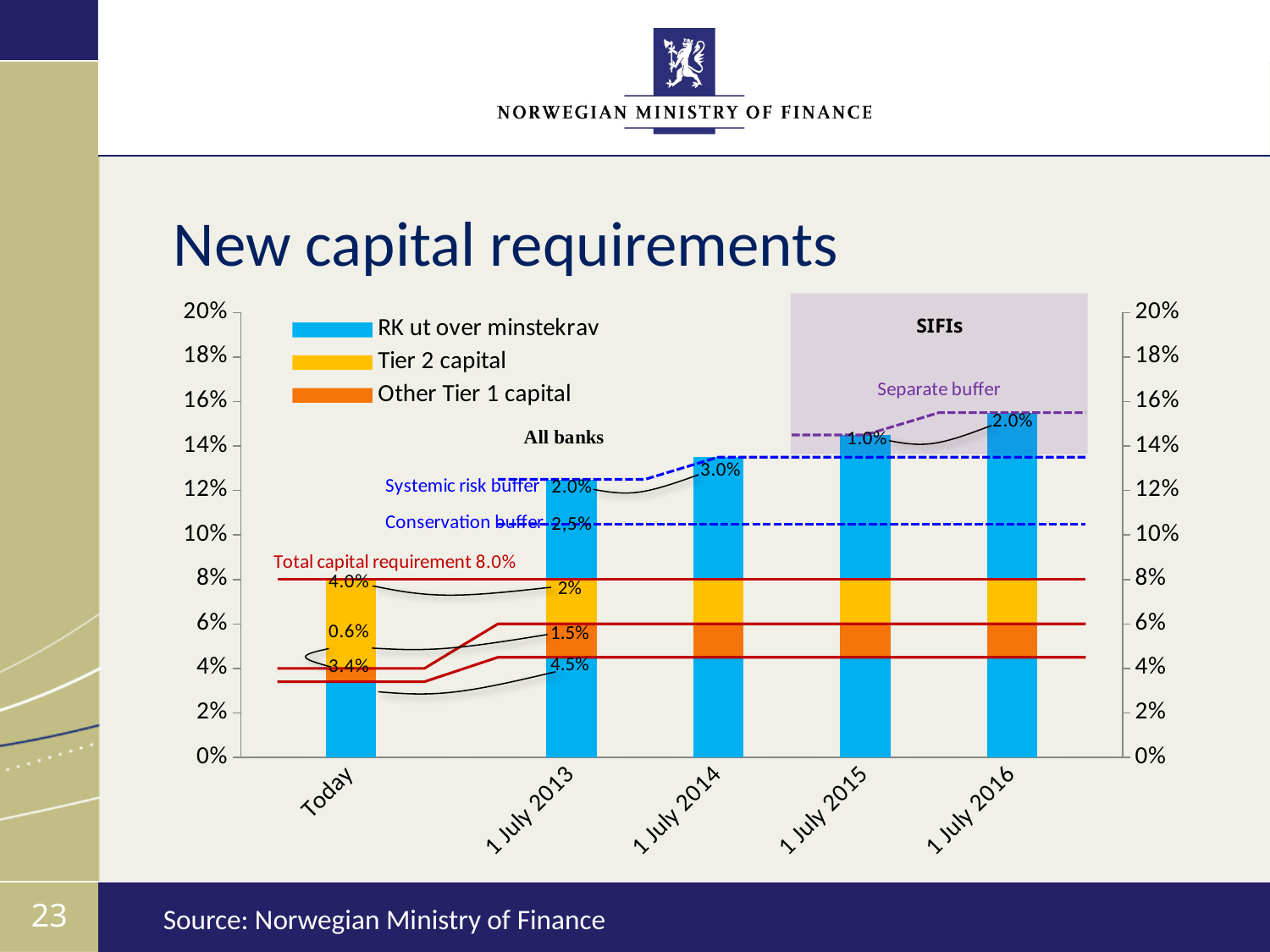
Do the total bar heights rise or fall from Today to 1 July 2016? rise What is the value of Other Tier 1 capital for 1 July 2013? 1.5% What is the first entry in the chart legend? RK ut over minstekrav What is the value of Tier 2 capital for Today? 4.0% What is the value of Tier 2 capital for 1 July 2013? 2% Which is larger, Tier 2 capital for Today or Tier 2 capital for 1 July 2013? Today How many series does the chart legend list? 3 What is the total capital requirement shown on the chart? 8.0% How many categories are shown along the x axis of the chart? 5 What kind of chart is shown on the slide? combination bar and line chart Is the total height of the bar for 1 July 2016 greater or less than 14%? greater What is the value of Other Tier 1 capital for Today? 0.6%